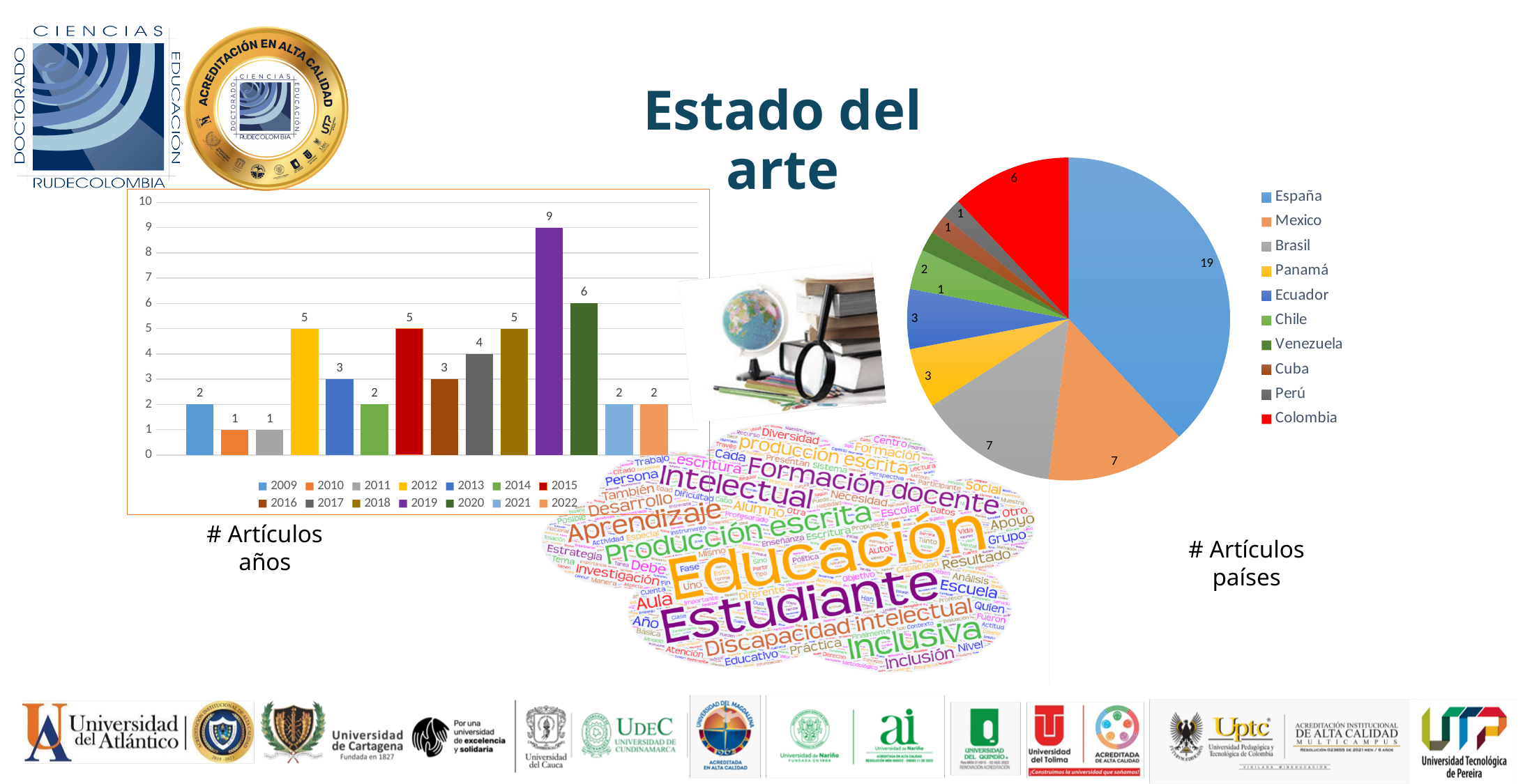
In the '# Artículos años' bar chart, what is the difference between the values for 2019 and 2020? 3 In the '# Artículos años' bar chart, how many years are shown in the legend? 14 In the '# Artículos años' bar chart, which year has the highest number of articles? 2019 In the '# Artículos países' pie chart, how many articles are shown for España? 19 In the '# Artículos países' pie chart, what is the difference between the values for España and Colombia? 13 In the '# Artículos años' bar chart, how many articles are shown for 2019? 9 In the '# Artículos países' pie chart, which country has the largest slice? España In the '# Artículos países' pie chart, how many countries are listed in the legend? 10 In the '# Artículos países' pie chart, what colour is the slice for Colombia? red What type of chart is the '# Artículos años' chart? bar chart In the '# Artículos años' bar chart, which is larger, the value for 2013 or the value for 2014? 2013 In the '# Artículos años' bar chart, what is the value for 2017? 4